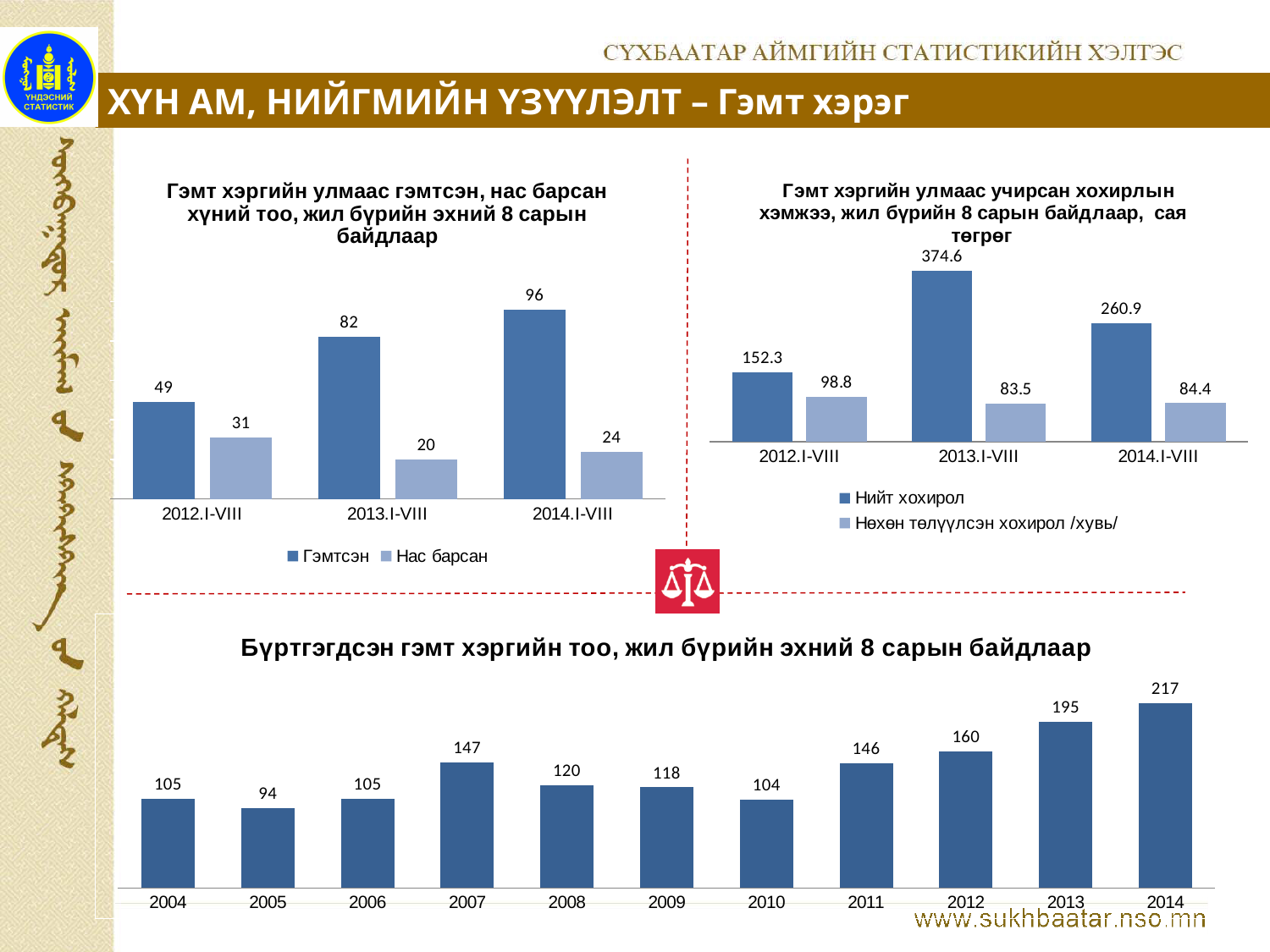
In the top-left chart (Гэмт хэргийн улмаас гэмтсэн, нас барсан хүний тоо), how many series does the legend list? 2 In the bottom chart (Бүртгэгдсэн гэмт хэргийн тоо), which year has the lowest value? 2005 What kind of chart is the bottom chart (Бүртгэгдсэн гэмт хэргийн тоо)? bar chart In the top-left chart (Гэмт хэргийн улмаас гэмтсэн, нас барсан хүний тоо), what is the value of Нас барсан for 2012.I-VIII? 31 In the top-left chart (Гэмт хэргийн улмаас гэмтсэн, нас барсан хүний тоо), what is the value of Гэмтсэн for 2013.I-VIII? 82 In the bottom chart (Бүртгэгдсэн гэмт хэргийн тоо), what is the difference between the values for 2014 and 2004? 112 In the bottom chart (Бүртгэгдсэн гэмт хэргийн тоо), how many years are shown on the x axis? 11 In the bottom chart (Бүртгэгдсэн гэмт хэргийн тоо), what is the value for 2013? 195 In the top-right chart (Гэмт хэргийн улмаас учирсан хохирлын хэмжээ), which period has the lowest Нийт хохирол value? 2012.I-VIII In the top-right chart (Гэмт хэргийн улмаас учирсан хохирлын хэмжээ), what is the value of Нийт хохирол for 2013.I-VIII? 374.6 In the top-right chart (Гэмт хэргийн улмаас учирсан хохирлын хэмжээ), is the Нийт хохирол value for 2014.I-VIII larger or smaller than for 2013.I-VIII? smaller In the bottom chart (Бүртгэгдсэн гэмт хэргийн тоо), which year has the highest value? 2014